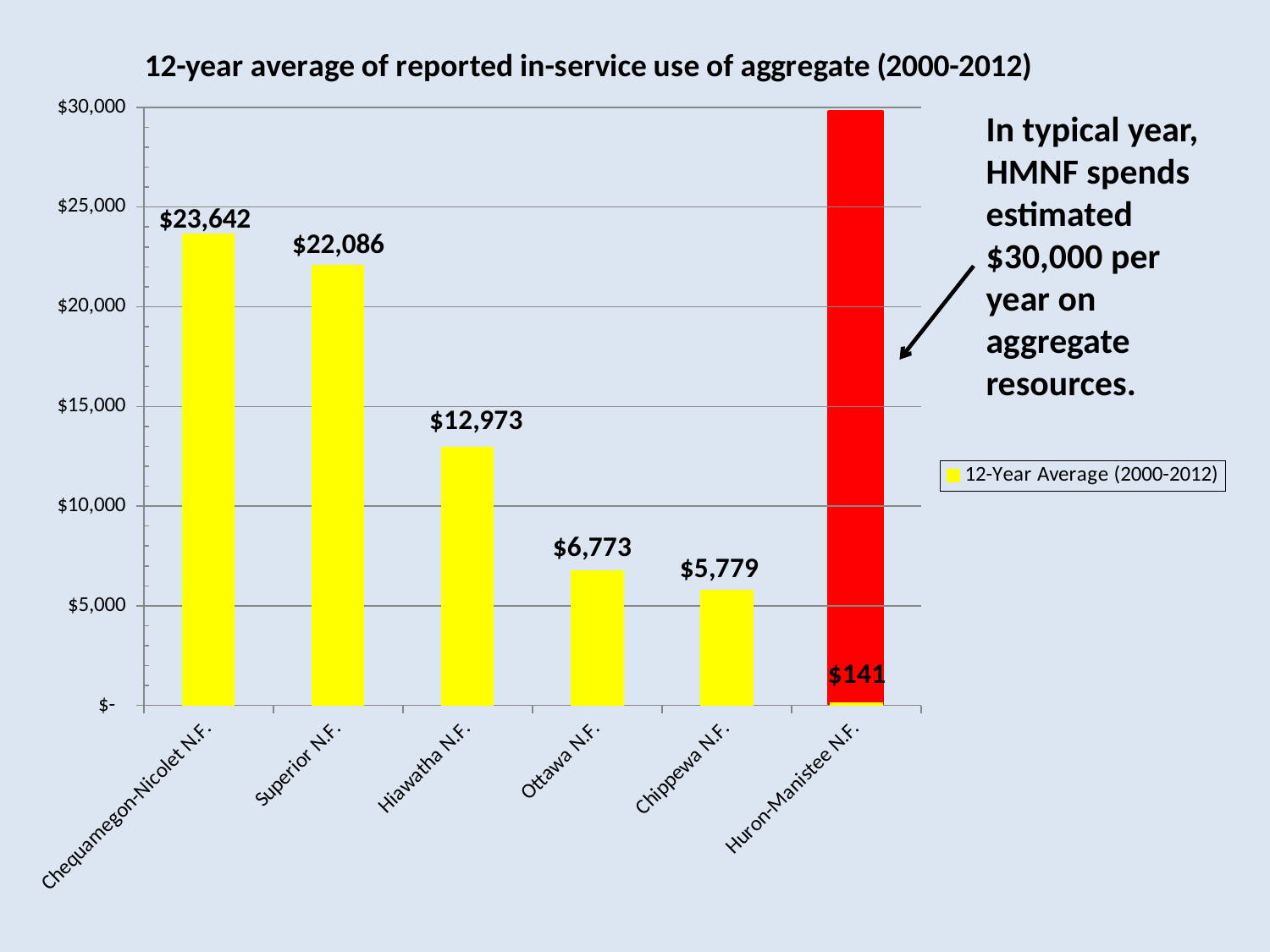
Which has a larger value, Hiawatha N.F. or Ottawa N.F.? Hiawatha N.F. What is the data label shown for Huron-Manistee N.F.? $141 What is the value shown for Hiawatha N.F.? $12,973 What is the difference between the values for Ottawa N.F. and Chippewa N.F.? $994 What is the legend entry shown for the series? 12-Year Average (2000-2012) What is the value shown for Superior N.F.? $22,086 Among the yellow bars, which national forest has the highest value? Chequamegon-Nicolet N.F. What is the difference between the values for Chequamegon-Nicolet N.F. and Superior N.F.? $1,555 What is the value shown for Ottawa N.F.? $6,773 How many national forests are shown on the x axis? 6 What is the 12-year average value shown for Chequamegon-Nicolet N.F.? $23,642 What kind of chart is this? Bar chart